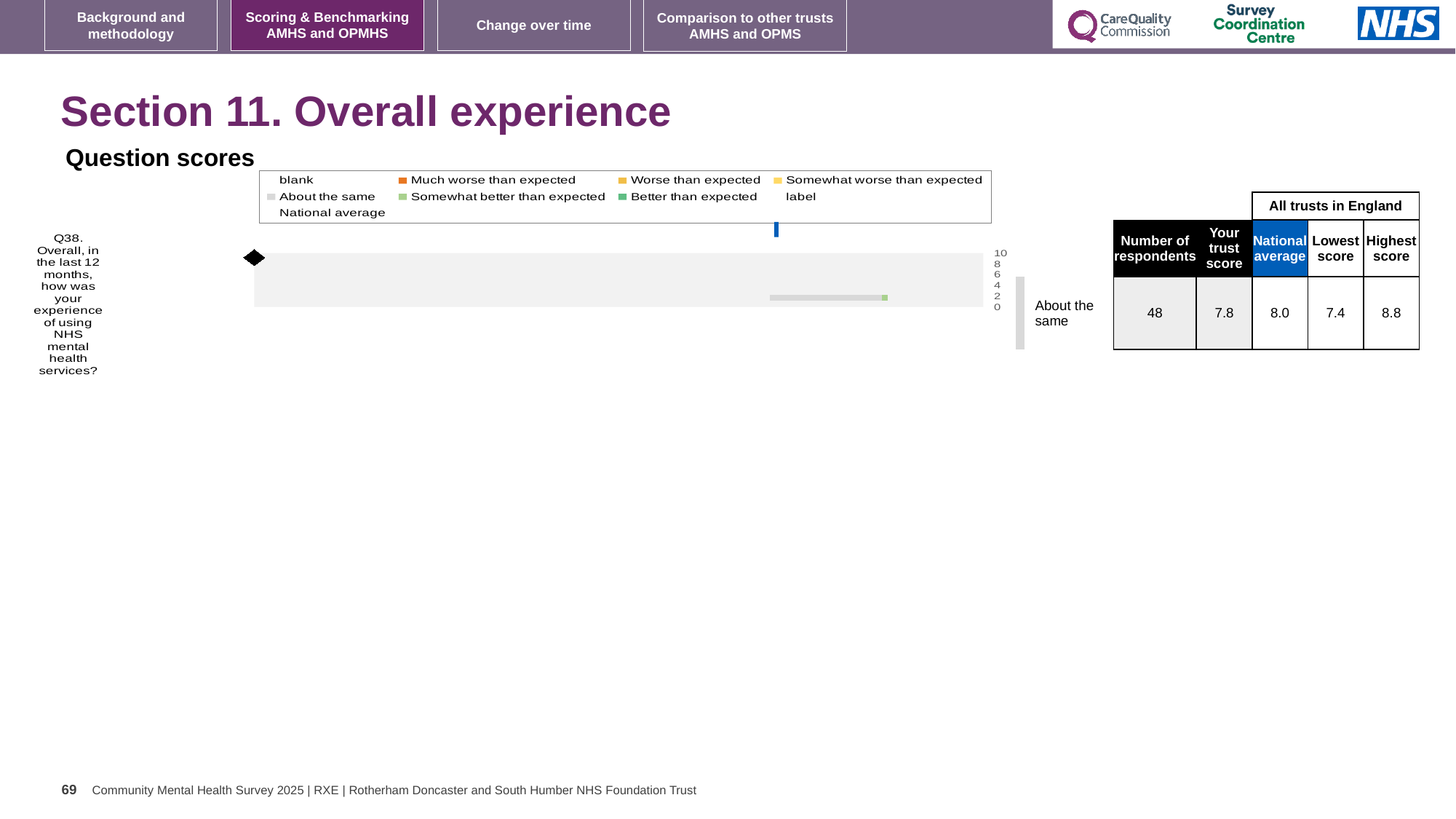
What is the difference between the highest and lowest scores among all trusts in England for Q38? 1.4 What is the trust's score for Q38 shown alongside the question scores chart? 7.8 How is the trust's Q38 score categorised relative to expectations in the question scores chart? About the same How many respondents answered Q38? 48 How many survey questions are plotted in the question scores chart? 1 What kind of chart is used to show the question scores on this slide? bar chart Which question is plotted in the question scores chart? Q38. Overall, in the last 12 months, how was your experience of using NHS mental health services? What is the national average score for Q38 shown alongside the question scores chart? 8.0 What is the lowest score among all trusts in England for Q38? 7.4 What is the difference between the national average and the trust's score for Q38? 0.2 What is the highest score among all trusts in England for Q38? 8.8 Is the trust's Q38 score higher or lower than the national average? lower